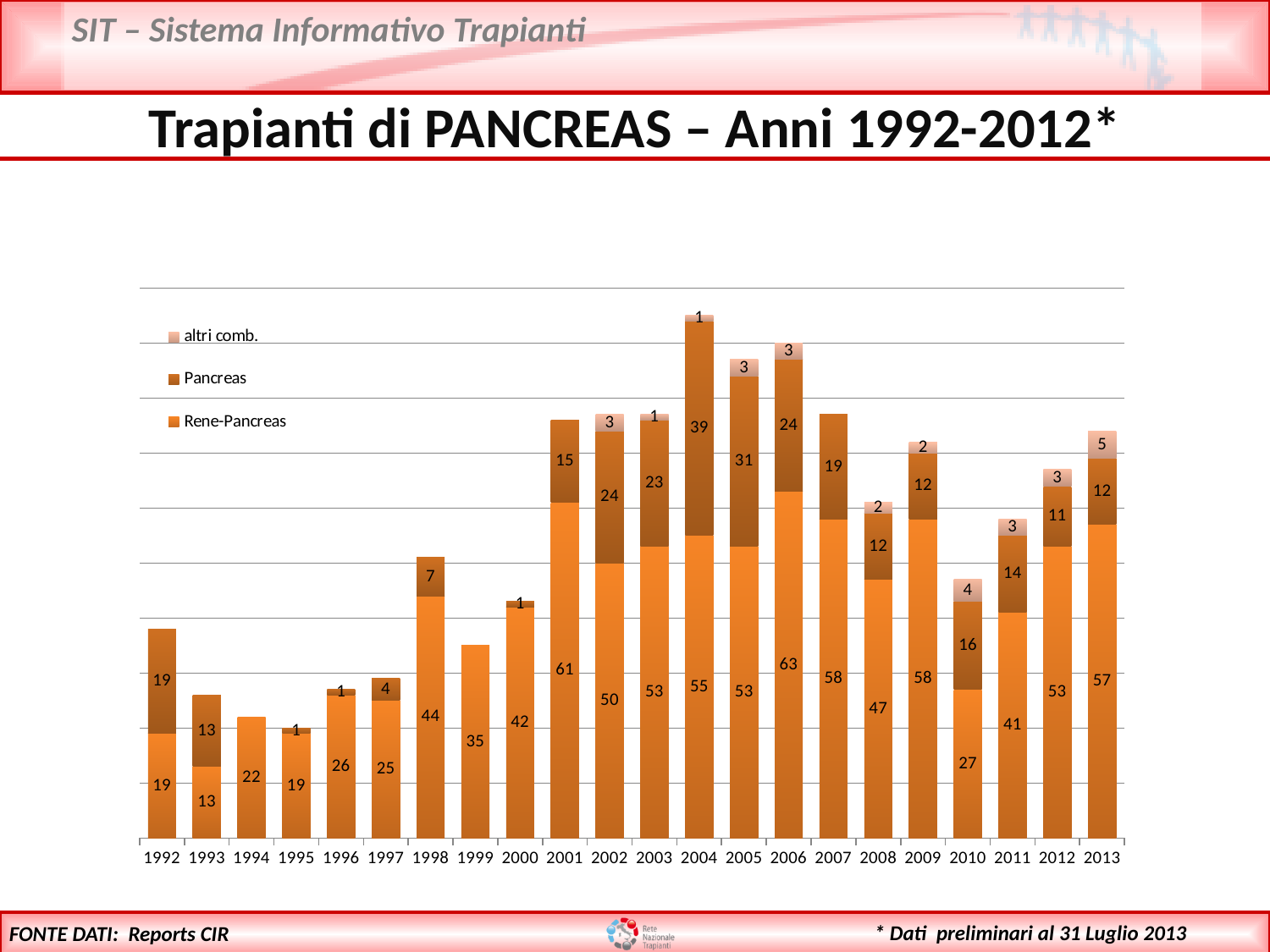
Which is larger, the Rene-Pancreas value for 1998 or for 1999? 1998 What is the altri comb. value for 2013? 5 What is the Pancreas value for 2004? 39 What is the total of the stacked bar for 2013? 74 How many years are shown on the x axis? 22 How many series does the legend list? 3 What kind of chart is shown on the slide? bar chart Which series is shown in the lightest colour in the legend? altri comb. What is the difference between the Rene-Pancreas values for 2001 and 2010? 34 Which year has the highest Pancreas value? 2004 Which year has the highest total across all series? 2004 What is the Rene-Pancreas value for 2006? 63